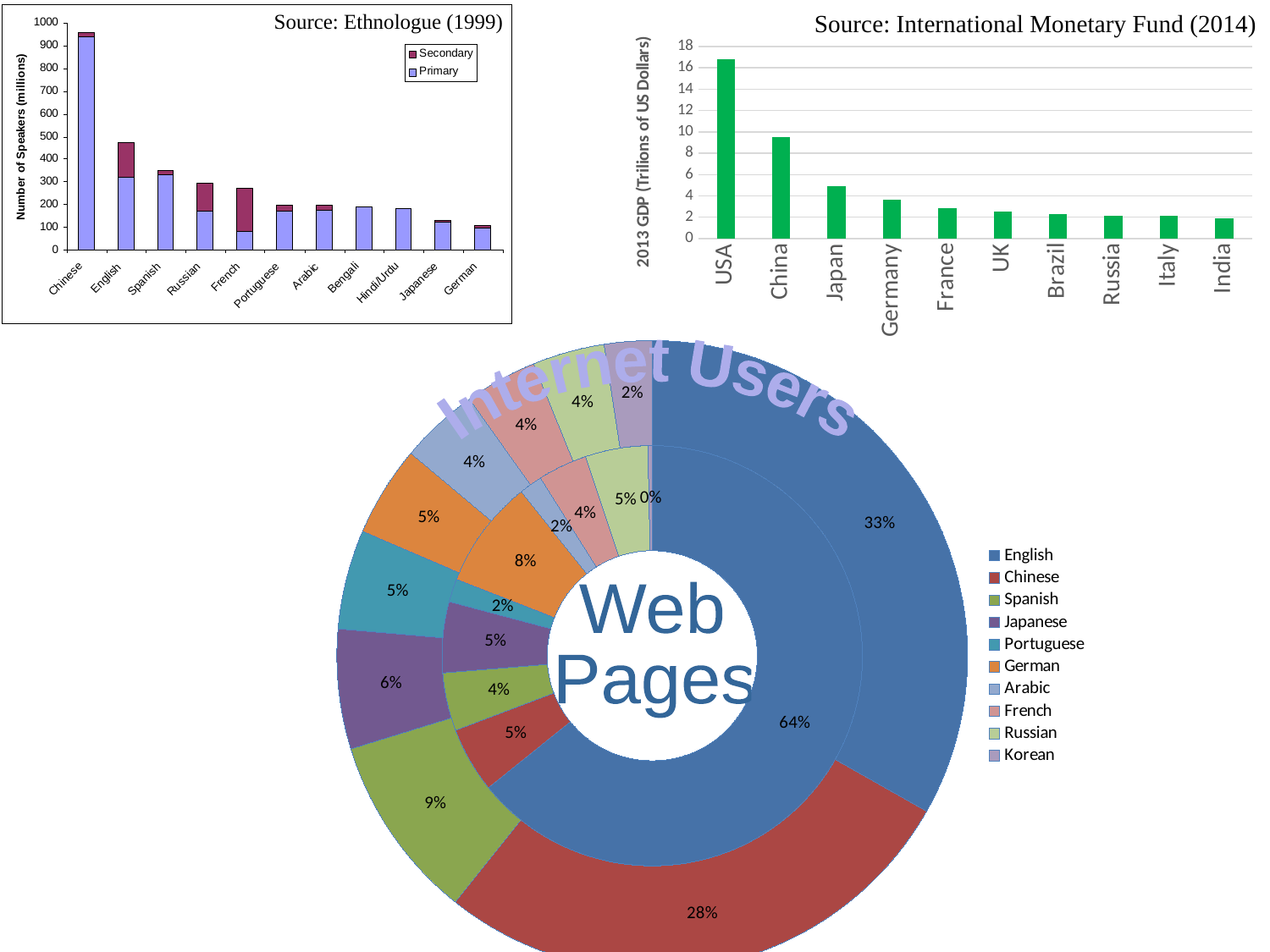
In the top-left chart (Number of Speakers), how many languages are shown on the x axis? 11 In the bottom doughnut chart, how many languages does the legend list? 10 In the top-left chart (Number of Speakers), how many series does the legend list? 2 In the bottom doughnut chart, what share of Internet Users (outer ring) is English? 33% In the top-left chart (Number of Speakers), which has the taller total bar, English or Spanish? English In the bottom doughnut chart, what share of Web Pages (inner ring) is German? 8% In the top-right chart (2013 GDP), is the value for USA greater or less than 16? greater In the top-left chart (Number of Speakers), which language has the tallest bar? Chinese In the top-right chart (2013 GDP), how many countries are shown? 10 In the top-left chart (Number of Speakers), is the total value for Chinese greater or less than 900? greater In the top-right chart (2013 GDP), which country has the highest GDP? USA What kind of chart is the top-left chart with the source Ethnologue (1999)? Bar chart